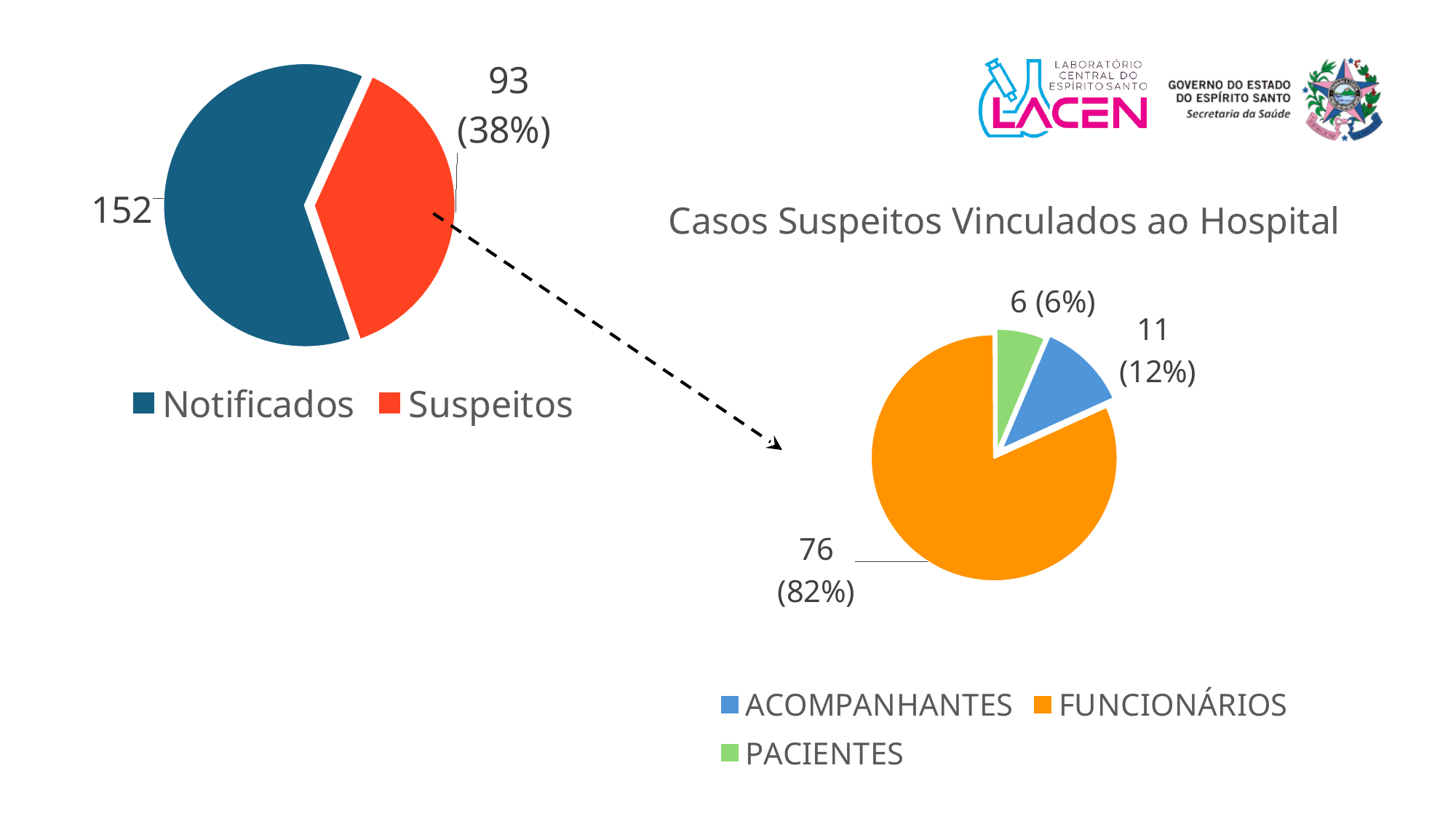
In the chart 'Casos Suspeitos Vinculados ao Hospital', what is the value for ACOMPANHANTES? 11 In the chart 'Casos Suspeitos Vinculados ao Hospital', how many categories does the legend list? 3 In the chart 'Casos Suspeitos Vinculados ao Hospital', which category is the smallest? PACIENTES In the pie chart on the left, what is the value for Notificados? 152 What kind of chart is 'Casos Suspeitos Vinculados ao Hospital'? Pie chart In the pie chart on the left, what share of the pie is Suspeitos? 38% In the pie chart on the left, what is the value for Suspeitos? 93 In the pie chart on the left, which slice is larger, Notificados or Suspeitos? Notificados In the chart 'Casos Suspeitos Vinculados ao Hospital', which category is the largest? FUNCIONÁRIOS In the chart 'Casos Suspeitos Vinculados ao Hospital', what share of the pie is PACIENTES? 6% In the pie chart on the left, what is the difference between Notificados and Suspeitos? 59 In the chart 'Casos Suspeitos Vinculados ao Hospital', what is the value for FUNCIONÁRIOS? 76